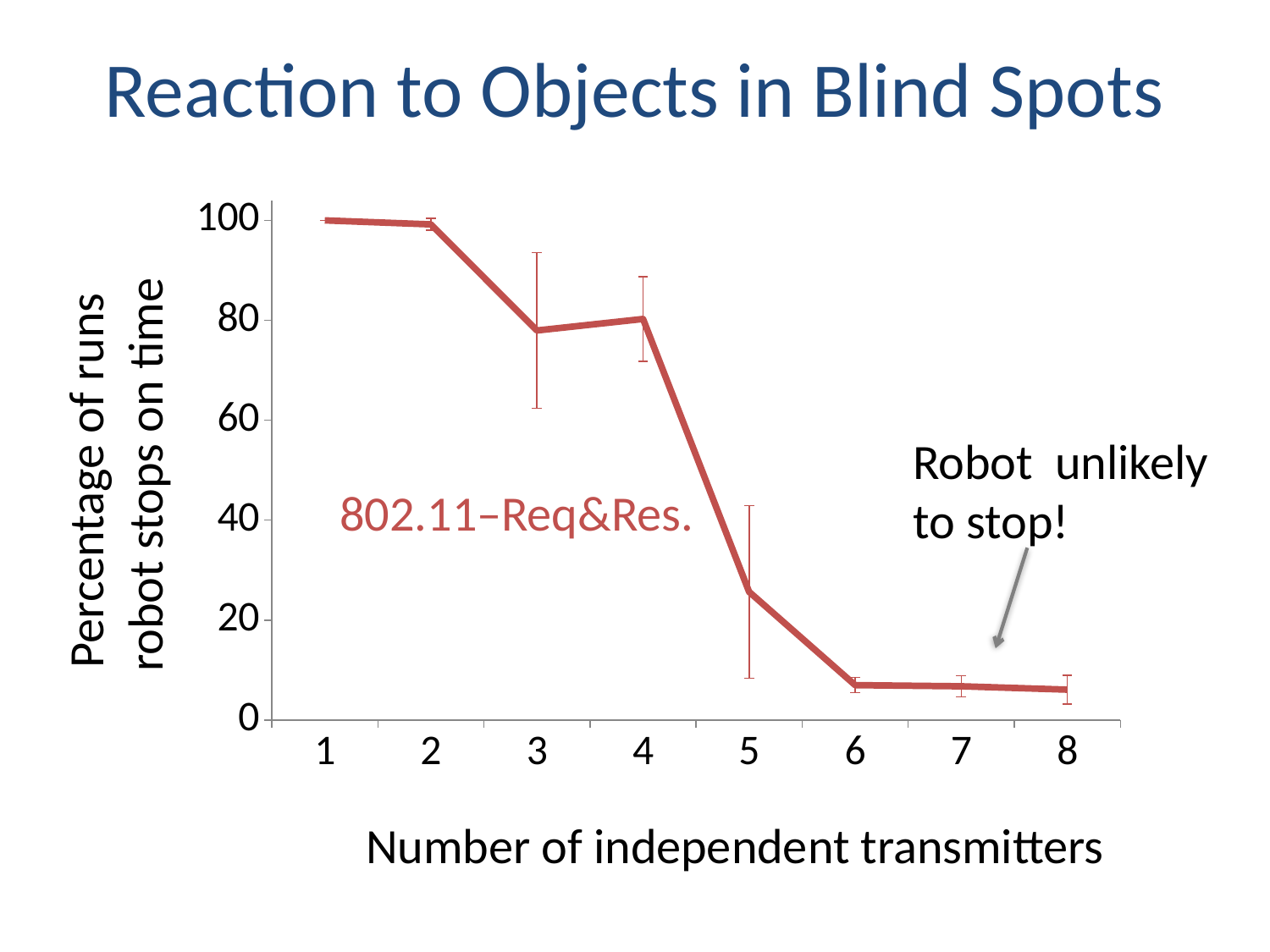
Which number of independent transmitters has the highest percentage of runs the robot stops on time? 1 Which has a higher percentage of runs the robot stops on time: 2 transmitters or 5 transmitters? 2 transmitters Is the value for 6 independent transmitters greater or less than 20? less What is the name of the plotted series written in red on the chart? 802.11–Req&Res. Is the value for 4 independent transmitters greater or less than 60? greater Is the value for 5 independent transmitters greater or less than 40? less What is the label of the x axis? Number of independent transmitters What kind of chart is shown on the slide? line chart Do the values rise or fall as the number of independent transmitters increases? fall How many data points are plotted along the x axis? 8 What is the percentage of runs the robot stops on time with 1 independent transmitter? 100